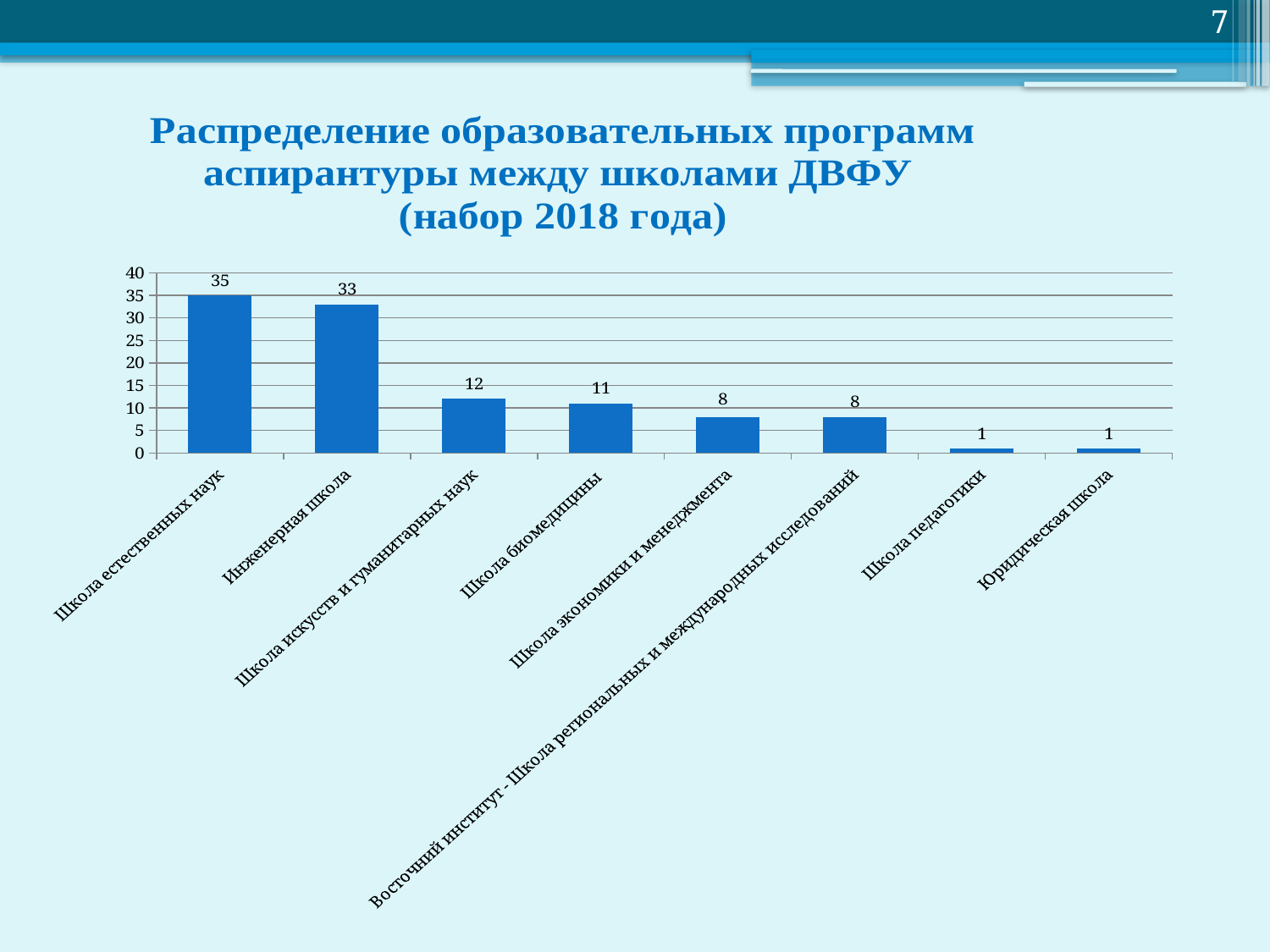
Which is larger, the value for Школа искусств и гуманитарных наук or the value for Школа биомедицины? Школа искусств и гуманитарных наук What is the value for Инженерная школа? 33 What is the value for Школа естественных наук? 35 What is the value for Школа биомедицины? 11 What is the value for Юридическая школа? 1 Do the values rise or fall from left to right along the x axis? fall Which category has the highest value? Школа естественных наук How many categories are shown on the x axis? 8 What is the value for Школа экономики и менеджмента? 8 What kind of chart is shown on the slide? bar chart What is the difference between the values for Школа естественных наук and Инженерная школа? 2 What is the value for Школа искусств и гуманитарных наук? 12